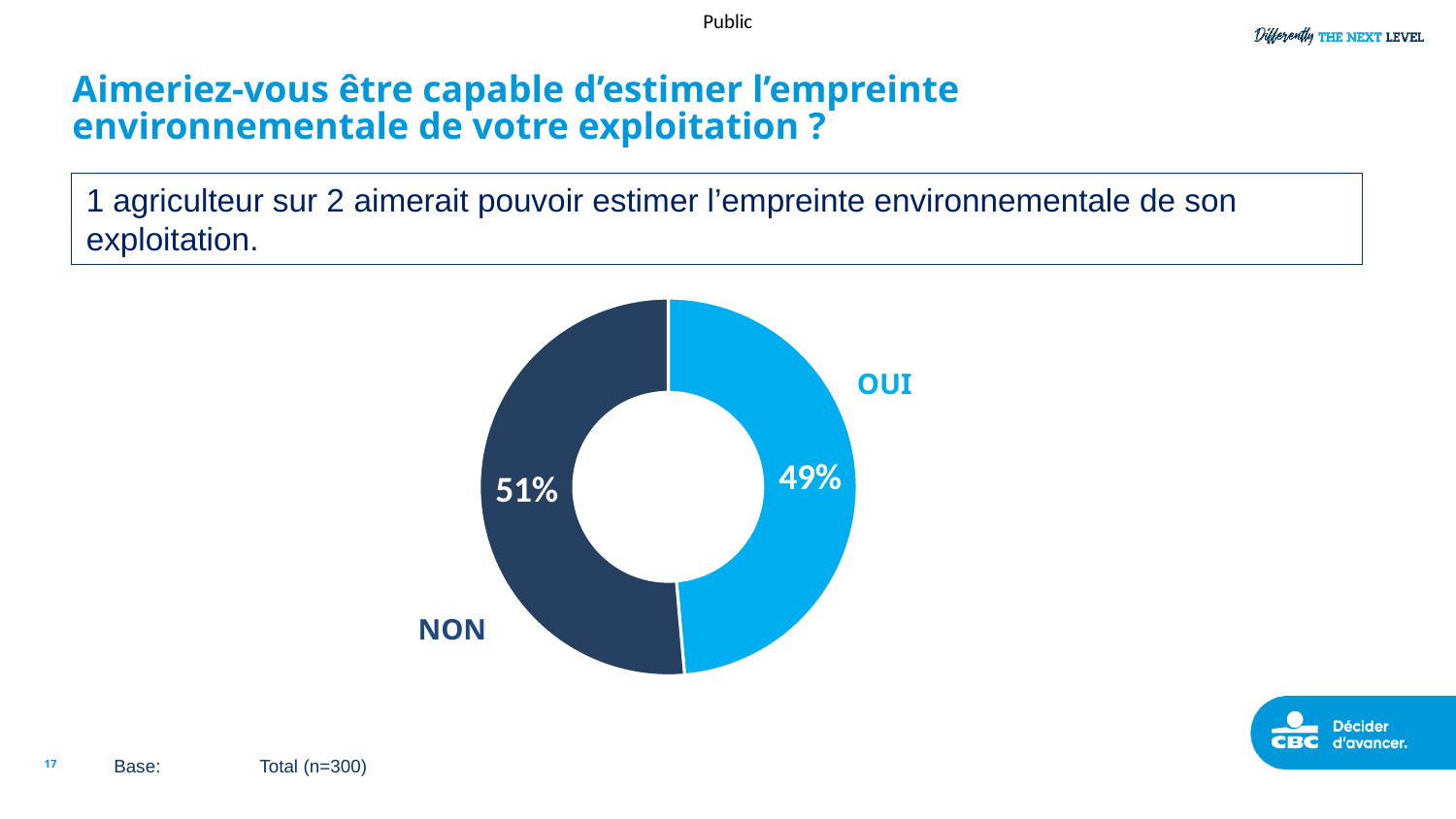
Which response has the larger share, OUI or NON? NON What percentage of respondents answered OUI? 49% Which category has the highest share in the chart? NON What is the difference in percentage points between NON and OUI? 2 percentage points How many categories are shown in the chart? 2 What is the base (sample size) stated for the chart? Total (n=300) What kind of chart is shown on the slide? Pie chart (doughnut) Which category has the lowest share in the chart? OUI What colour is the OUI slice? Light blue What is the total of the two slices shown in the chart? 100% What percentage of respondents answered NON? 51%